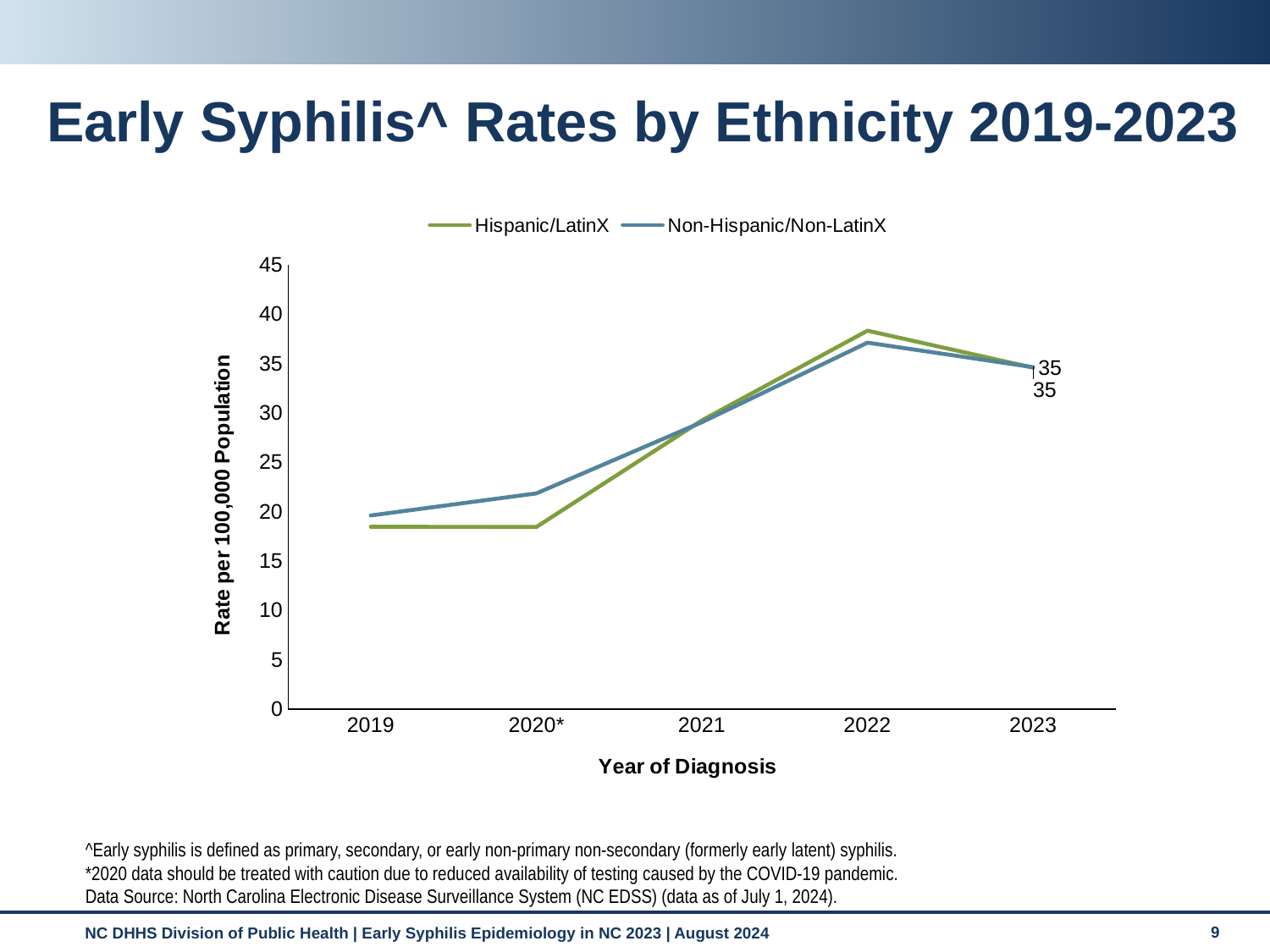
What is the Hispanic/LatinX rate in 2023? 35 Is the Hispanic/LatinX rate in 2019 greater or less than 20? less How many years are plotted along the x axis? 5 What is the Non-Hispanic/Non-LatinX rate in 2023? 35 Does the Hispanic/LatinX rate rise or fall from 2020* to 2022? rise What kind of chart is shown on the slide? line chart In which year is the Hispanic/LatinX rate highest? 2022 What is the difference between the Hispanic/LatinX and Non-Hispanic/Non-LatinX rates in 2023? 0 Is the Hispanic/LatinX rate in 2022 greater or less than 35? greater In 2020*, which series has the higher rate, Hispanic/LatinX or Non-Hispanic/Non-LatinX? Non-Hispanic/Non-LatinX What is the title of the y axis? Rate per 100,000 Population How many series does the legend list? 2